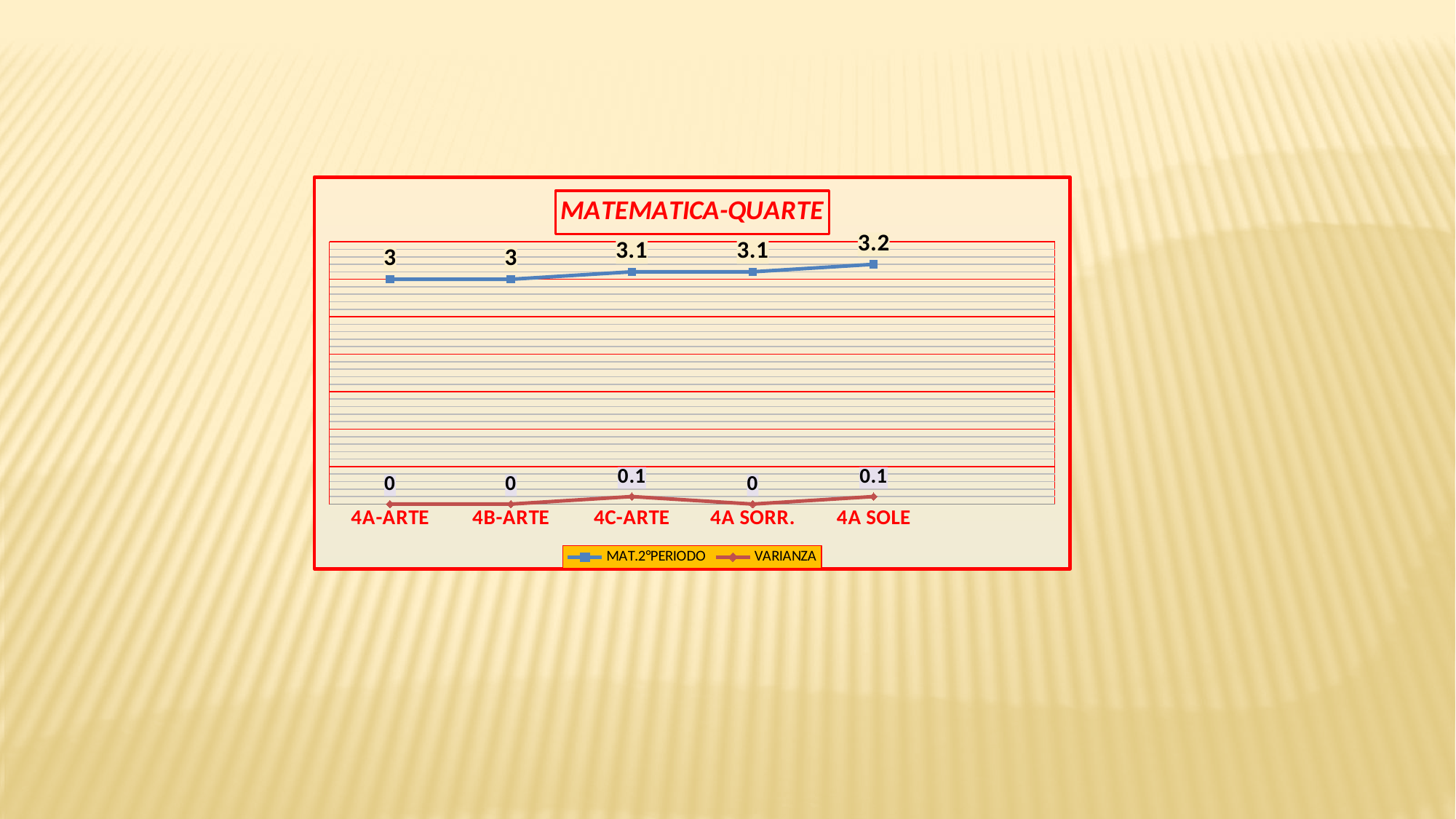
What is the difference between the MAT.2°PERIODO values for 4A SOLE and 4A-ARTE? 0.2 What is the MAT.2°PERIODO value for 4A SOLE? 3.2 Which category has the highest MAT.2°PERIODO value? 4A SOLE Does the MAT.2°PERIODO series rise or fall from 4A-ARTE to 4A SOLE? rise What is the title of the chart? MATEMATICA-QUARTE What kind of chart is shown? line chart What is the VARIANZA value for 4A SOLE? 0.1 What is the MAT.2°PERIODO value for 4C-ARTE? 3.1 How many categories are shown on the x axis? 5 How many series does the legend list? 2 Which is larger, the MAT.2°PERIODO value for 4C-ARTE or for 4B-ARTE? 4C-ARTE What is the VARIANZA value for 4A SORR.? 0